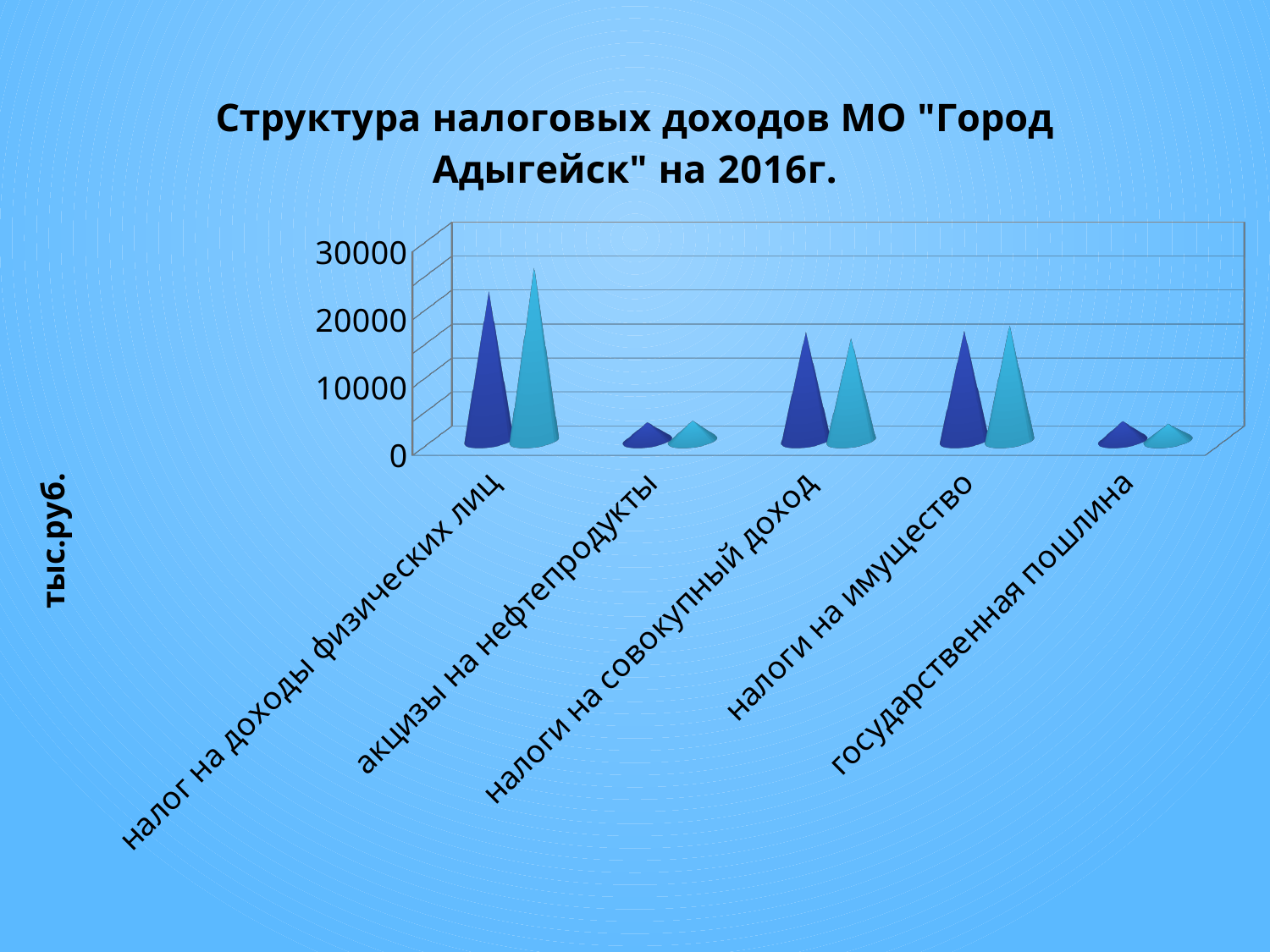
How many categories are shown on the x axis of the chart? 5 Which category has the highest values in the chart? налог на доходы физических лиц Which is larger, the dark blue value for налог на доходы физических лиц or the dark blue value for налоги на имущество? налог на доходы физических лиц Is the light blue value for налог на доходы физических лиц greater or less than 20000? greater What is the title of the chart? Структура налоговых доходов МО "Город Адыгейск" на 2016г. Is the dark blue value for налоги на совокупный доход greater or less than 10000? greater Is the light blue value for государственная пошлина greater or less than 10000? less Which is larger, the light blue value for налоги на совокупный доход or the light blue value for акцизы на нефтепродукты? налоги на совокупный доход What kind of chart is shown on the slide? bar chart